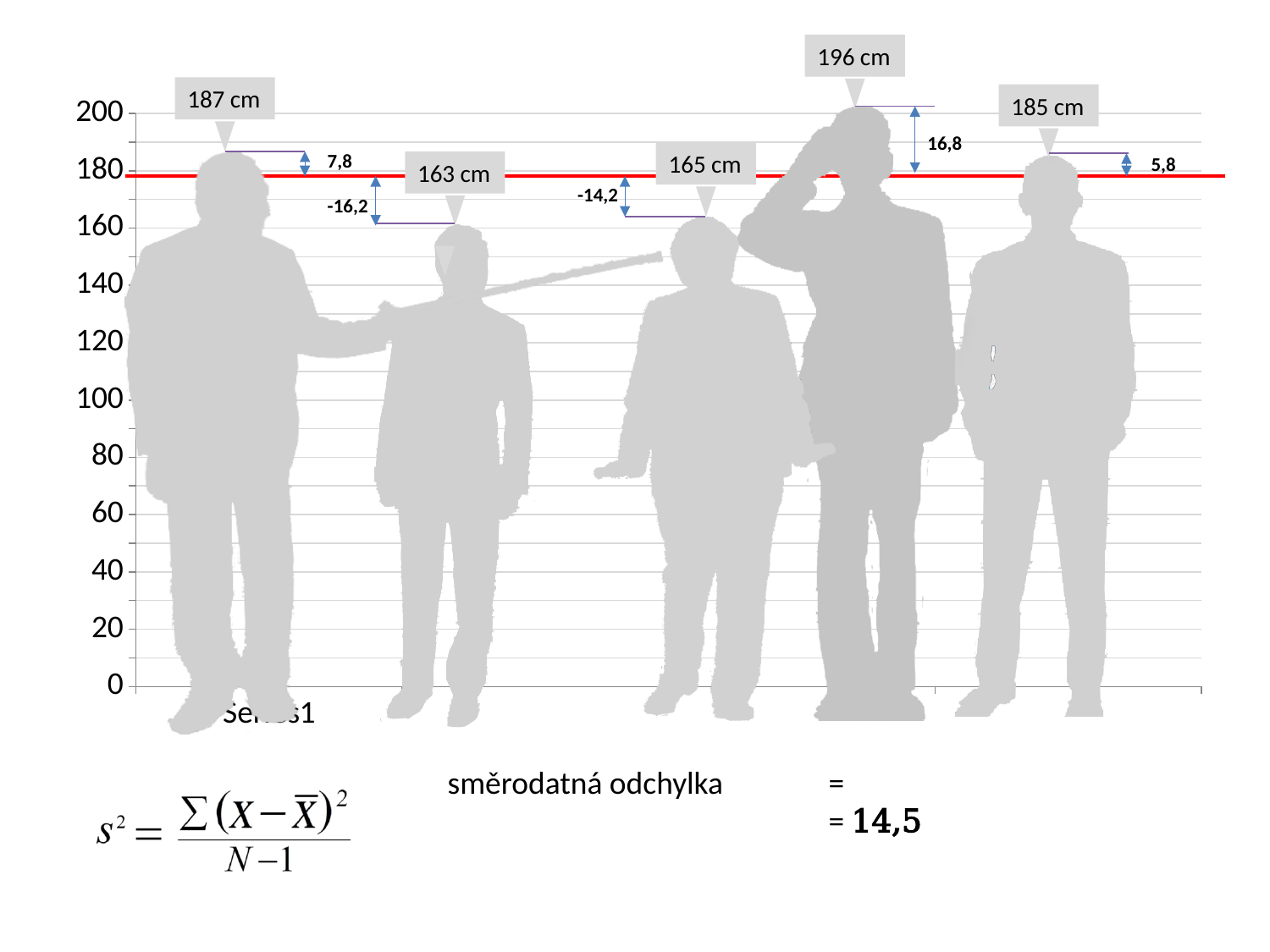
What is the height shown for the leftmost figure? 187 cm What value of the standard deviation (směrodatná odchylka) is given below the chart? 14,5 Is the height of the third figure from the left greater or less than 180? less What is the height shown for the second figure from the left? 163 cm What deviation from the red mean line is labelled for the fourth figure from the left? 16,8 Which is larger, the height of the leftmost figure or the height of the rightmost figure? The leftmost figure (187 cm) What is the difference between the tallest height (196 cm) and the shortest height (163 cm)? 33 cm Which figure has the greatest height? The fourth from the left (196 cm) How many figures (data points) are plotted on the chart? 5 What is the height shown for the middle (third) figure? 165 cm Which figure has the smallest height? The second from the left (163 cm) What is the height shown for the rightmost figure? 185 cm